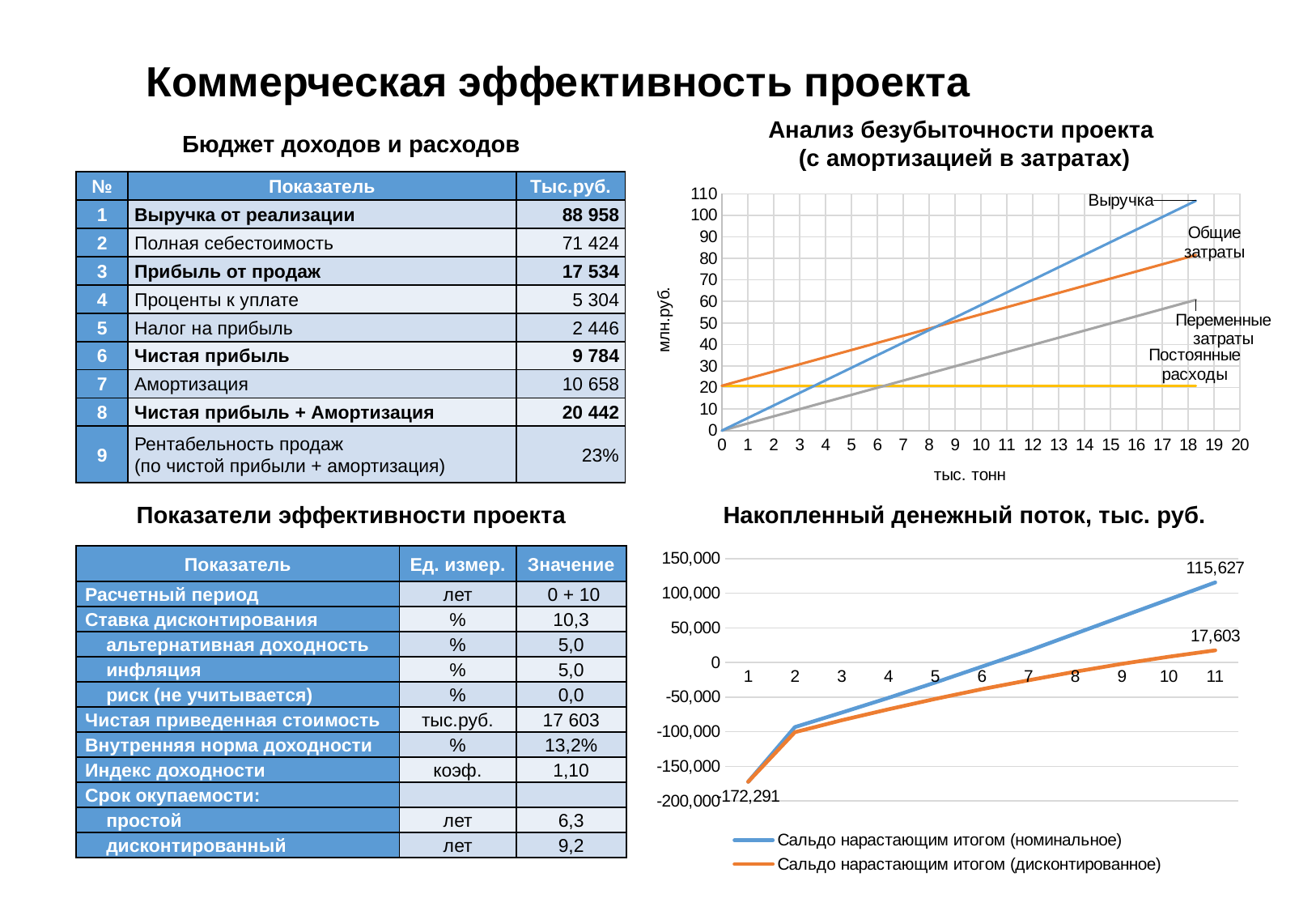
In the 'Накопленный денежный поток, тыс. руб.' chart, what is the difference between the nominal and discounted values at period 11? 98,024 In the 'Накопленный денежный поток, тыс. руб.' chart, how many series does the legend list? 2 In the 'Накопленный денежный поток, тыс. руб.' chart, what is the value of 'Сальдо нарастающим итогом (номинальное)' at period 11? 115,627 In the 'Анализ безубыточности проекта' chart, how many lines are plotted? 4 What kind of chart is the 'Анализ безубыточности проекта' chart? line chart In the 'Анализ безубыточности проекта' chart, is the value of Выручка at 18 тыс. тонн greater or less than 100? greater In the 'Накопленный денежный поток, тыс. руб.' chart, which series is larger at period 11, the nominal or the discounted balance? Сальдо нарастающим итогом (номинальное) In the 'Накопленный денежный поток, тыс. руб.' chart, how many periods are shown on the x axis? 11 In the 'Накопленный денежный поток, тыс. руб.' chart, what is the value of 'Сальдо нарастающим итогом (дисконтированное)' at period 11? 17,603 In the 'Анализ безубыточности проекта' chart, is the value of Постоянные расходы at 10 тыс. тонн greater or less than 30? less In the 'Анализ безубыточности проекта' chart, which line is highest at 18 тыс. тонн? Выручка In the 'Анализ безубыточности проекта' chart, does the Выручка line rise or fall as тыс. тонн increases? rises